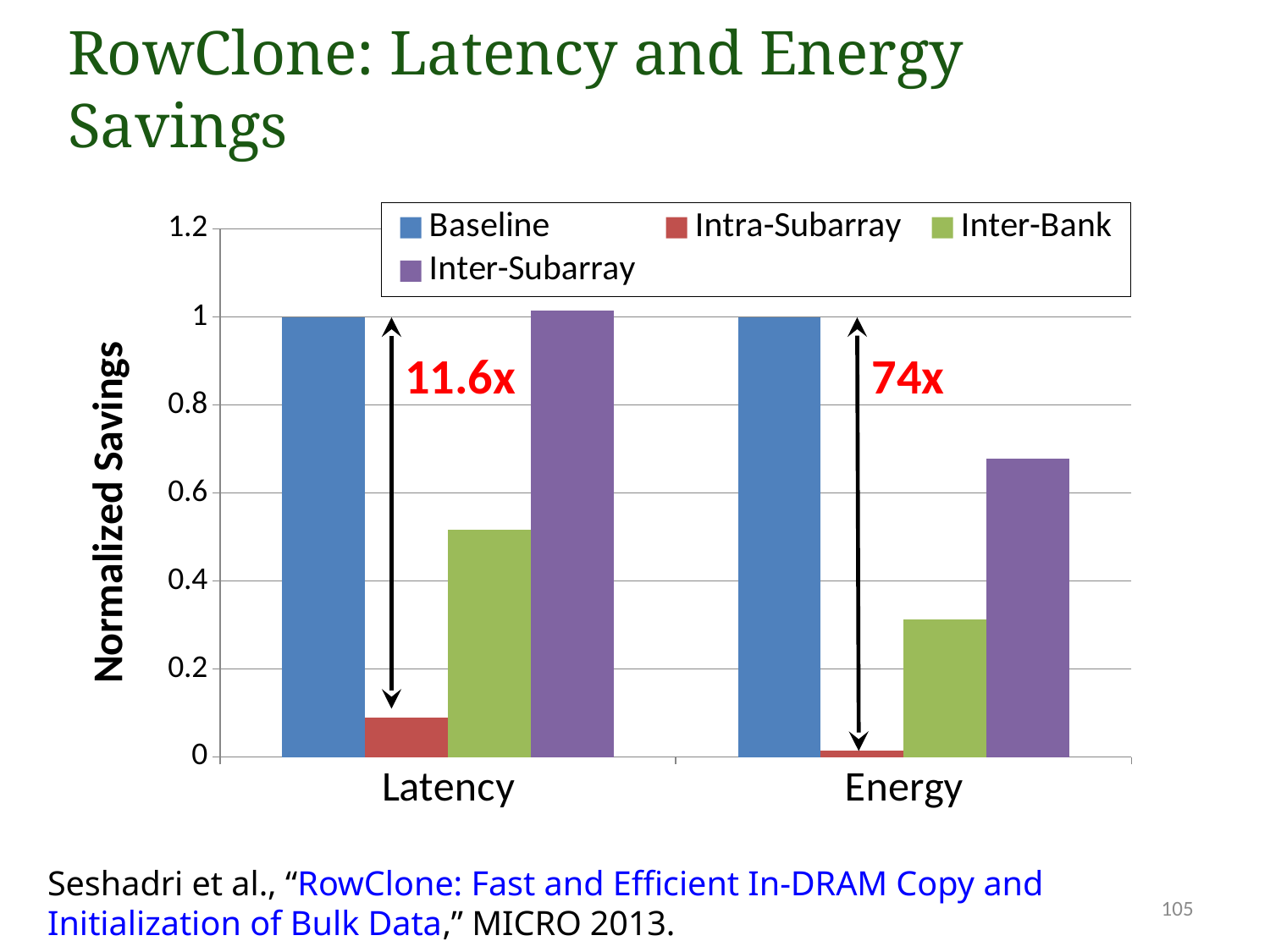
Which is larger: the Inter-Bank value for Latency or the Inter-Bank value for Energy? Latency What is the Baseline value for Energy? 1 What is the title of the y axis? Normalized Savings Which series has the lowest value for Latency? Intra-Subarray How many categories are shown on the x axis? 2 What kind of chart is shown on the slide? bar chart Is the Inter-Bank value for Latency greater or less than 0.4? greater Which series has the highest value for Energy? Baseline What is the Baseline value for Latency? 1 Is the Inter-Subarray value for Energy greater or less than 0.8? less How many series does the legend list? 4 Is the Intra-Subarray value for Latency greater or less than 0.2? less